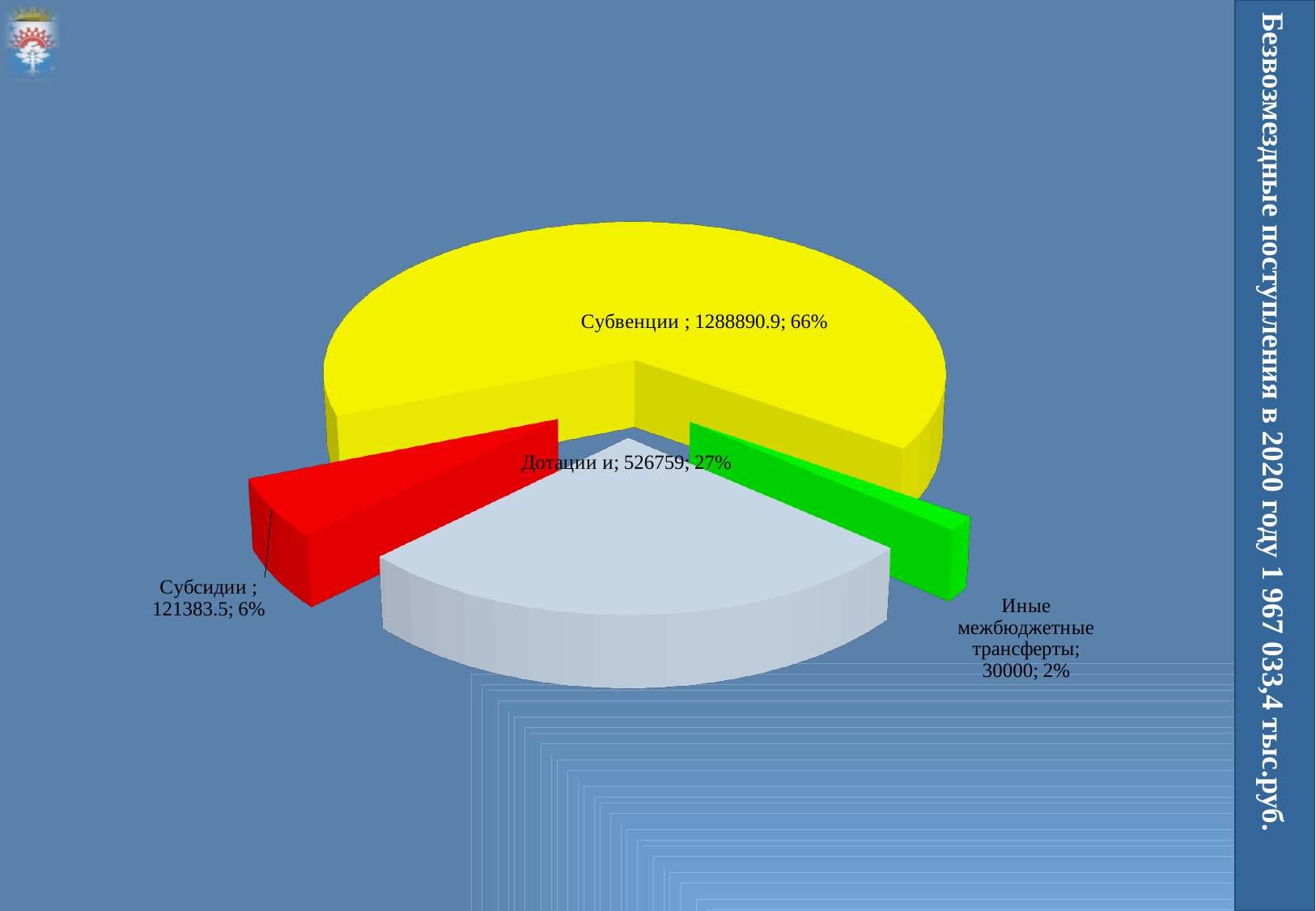
What colour is the Субвенции slice? Yellow What percentage share does the Дотации slice have? 27% How many slices does the pie chart have? 4 What percentage share does the Иные межбюджетные трансферты slice have? 2% What percentage share does the Субвенции slice have? 66% Which category has the smallest share of the pie? Иные межбюджетные трансферты What is the value shown for Субвенции? 1288890.9 Which is larger, the value for Дотации or the value for Субсидии? Дотации What is the value shown for Дотации? 526759 What is the value shown for Субсидии? 121383.5 What type of chart is shown on the slide? Pie chart Which category has the largest share of the pie? Субвенции